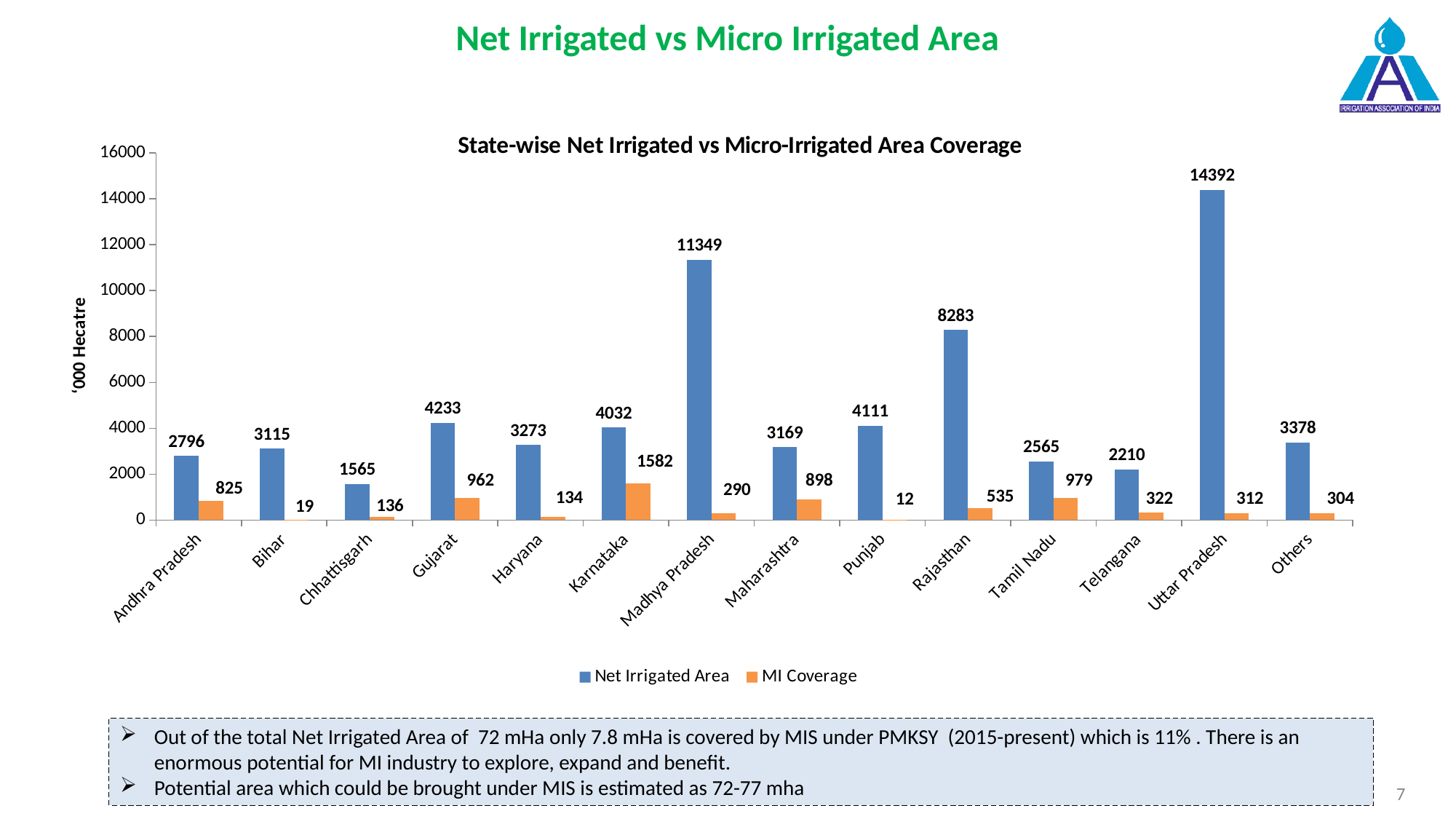
What is the Net Irrigated Area for Madhya Pradesh? 11349 Which category has the lowest MI Coverage? Punjab Which state has the highest Net Irrigated Area? Uttar Pradesh What is the difference between the Net Irrigated Area and MI Coverage for Gujarat? 3271 What is the title of the chart? State-wise Net Irrigated vs Micro-Irrigated Area Coverage How many categories are shown on the x axis? 14 Which is larger, the MI Coverage for Tamil Nadu or for Andhra Pradesh? Tamil Nadu How many series does the legend list? 2 What kind of chart is shown on the slide? Bar chart What is the MI Coverage value for Karnataka? 1582 What is the label on the vertical axis? '000 Hecatre Is the Net Irrigated Area for Rajasthan greater or less than 8000? greater